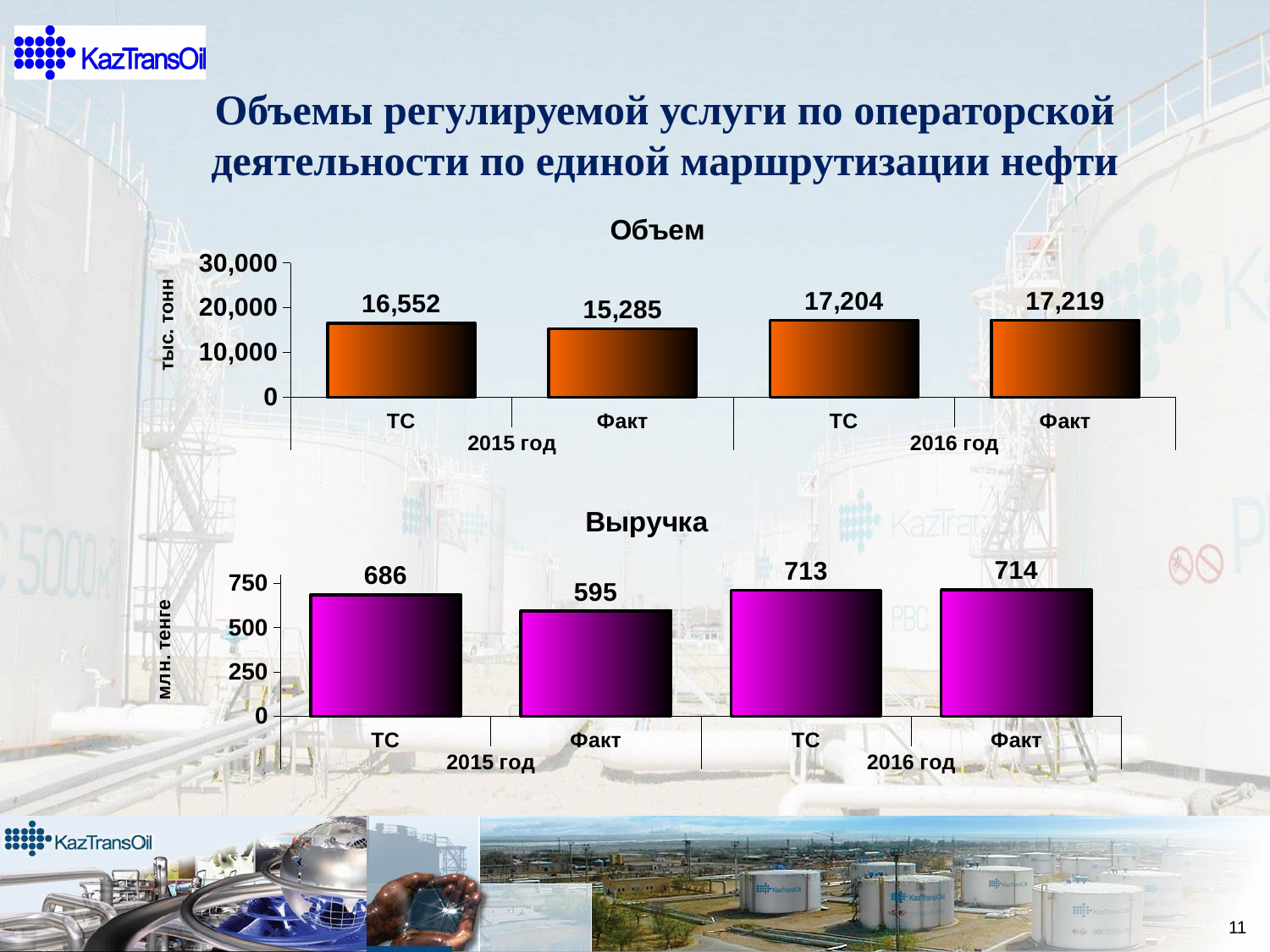
What type of chart is the 'Выручка' chart? bar chart In the 'Выручка' chart, which bar has the lowest value? Факт 2015 год In the 'Выручка' chart, what is the difference between ТС and Факт for 2015 год? 91 In the 'Объем' chart, what is the value for ТС in 2015 год? 16,552 In the 'Объем' chart, how many bars are plotted? 4 In the 'Выручка' chart, is the value for ТС in 2015 год greater or less than 500? greater In the 'Объем' chart, which bar has the lowest value? Факт 2015 год In the 'Объем' chart, what unit is shown on the vertical axis? тыс. тонн In the 'Выручка' chart, what is the value for Факт in 2015 год? 595 In the 'Объем' chart, what is the difference between ТС and Факт for 2015 год? 1,267 In the 'Выручка' chart, what is the value for ТС in 2016 год? 713 In the 'Объем' chart, what is the value for Факт in 2016 год? 17,219